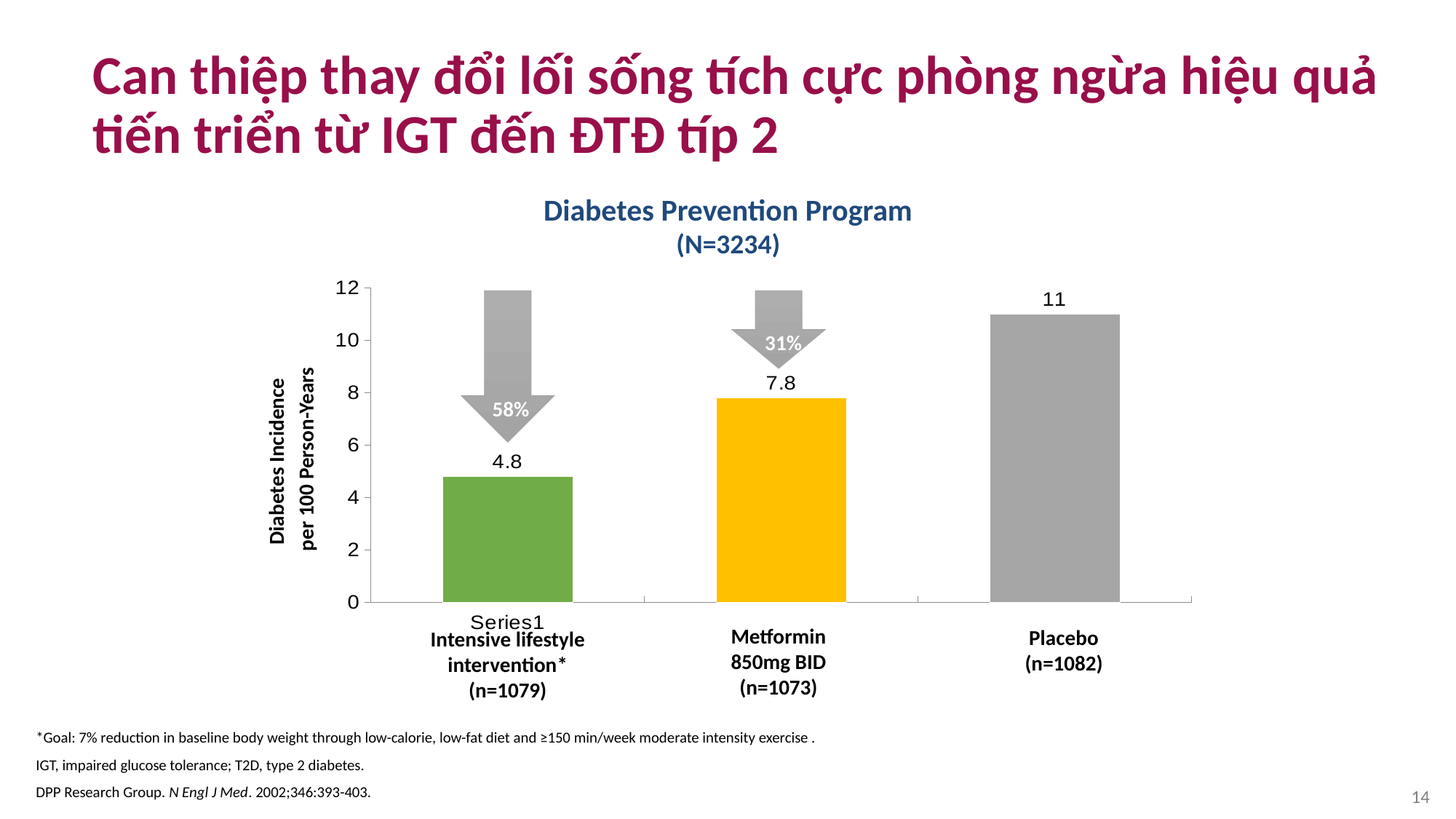
Which group has the highest diabetes incidence? Placebo Which has a higher diabetes incidence, Metformin 850mg BID or Placebo? Placebo What kind of chart is shown on the slide? Bar chart What is the diabetes incidence per 100 person-years for the Metformin 850mg BID group? 7.8 Is the value for the Placebo group greater or less than 10? greater What is the diabetes incidence per 100 person-years for the Intensive lifestyle intervention group? 4.8 What is the difference in diabetes incidence between the Metformin group and the Intensive lifestyle intervention group? 3 What is the difference in diabetes incidence between the Placebo group and the Metformin group? 3.2 How many groups are shown in the chart? 3 What percentage reduction is shown by the arrow above the Intensive lifestyle intervention bar? 58% What is the diabetes incidence per 100 person-years for the Placebo group? 11 Which group has the lowest diabetes incidence? Intensive lifestyle intervention